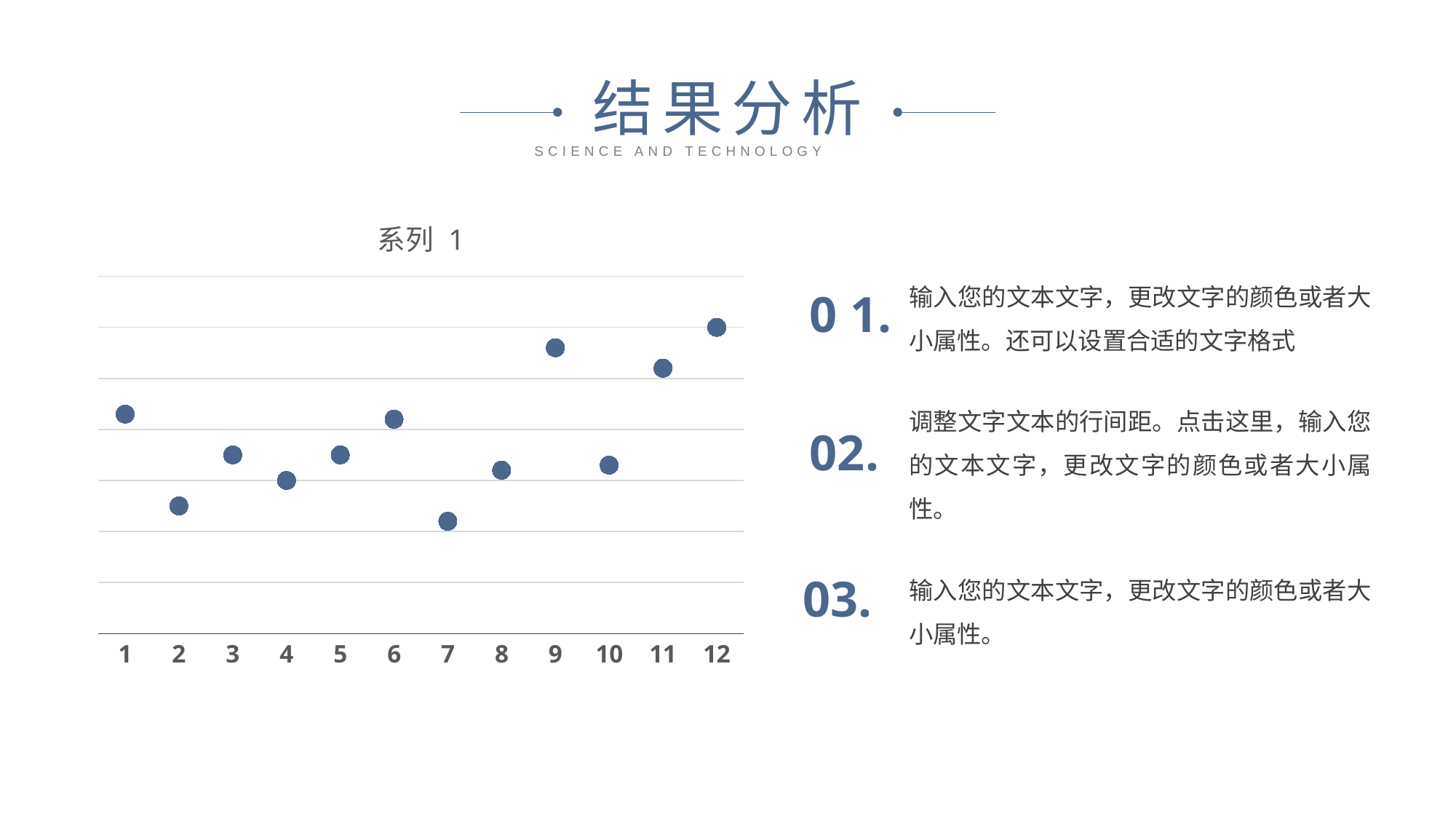
At which x-axis category is the plotted value highest? 12 At which x-axis category is the plotted value lowest? 7 Which has the larger value, category 1 or category 2? 1 Which has the larger value, category 1 or category 12? 12 Which has the larger value, category 2 or category 6? 6 Do the plotted values generally rise or fall from category 1 to category 12? rise How many data points are plotted in the chart? 12 What is the last category label on the x axis? 12 What is the title of the chart? 系列 1 What kind of chart is shown on the slide? scatter chart